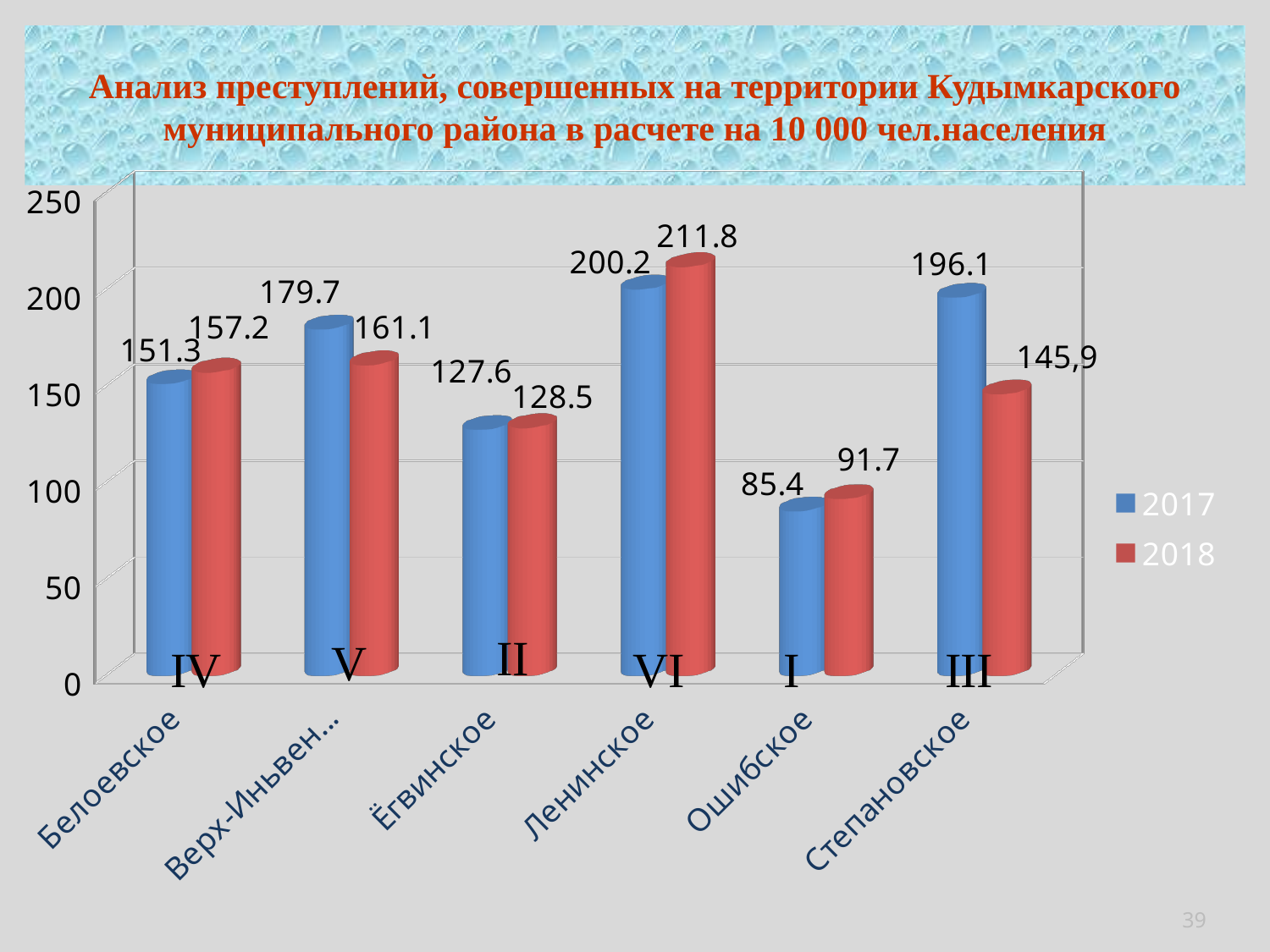
What is the value for Степановское in 2018? 145,9 Which category has the highest value in 2018? Ленинское What is the difference between the 2017 and 2018 values for Степановское? 50.2 What kind of chart is shown on the slide? Bar chart By how much did the value for Ленинское increase from 2017 to 2018? 11.6 For Ёгвинское, which year has the larger value, 2017 or 2018? 2018 What is the value for Ошибское in 2017? 85.4 How many series does the legend list? 2 What is the value for Ленинское in 2018? 211.8 Which category has the lowest value in 2017? Ошибское What is the value for Белоевское in 2017? 151.3 How many categories are shown on the x axis? 6